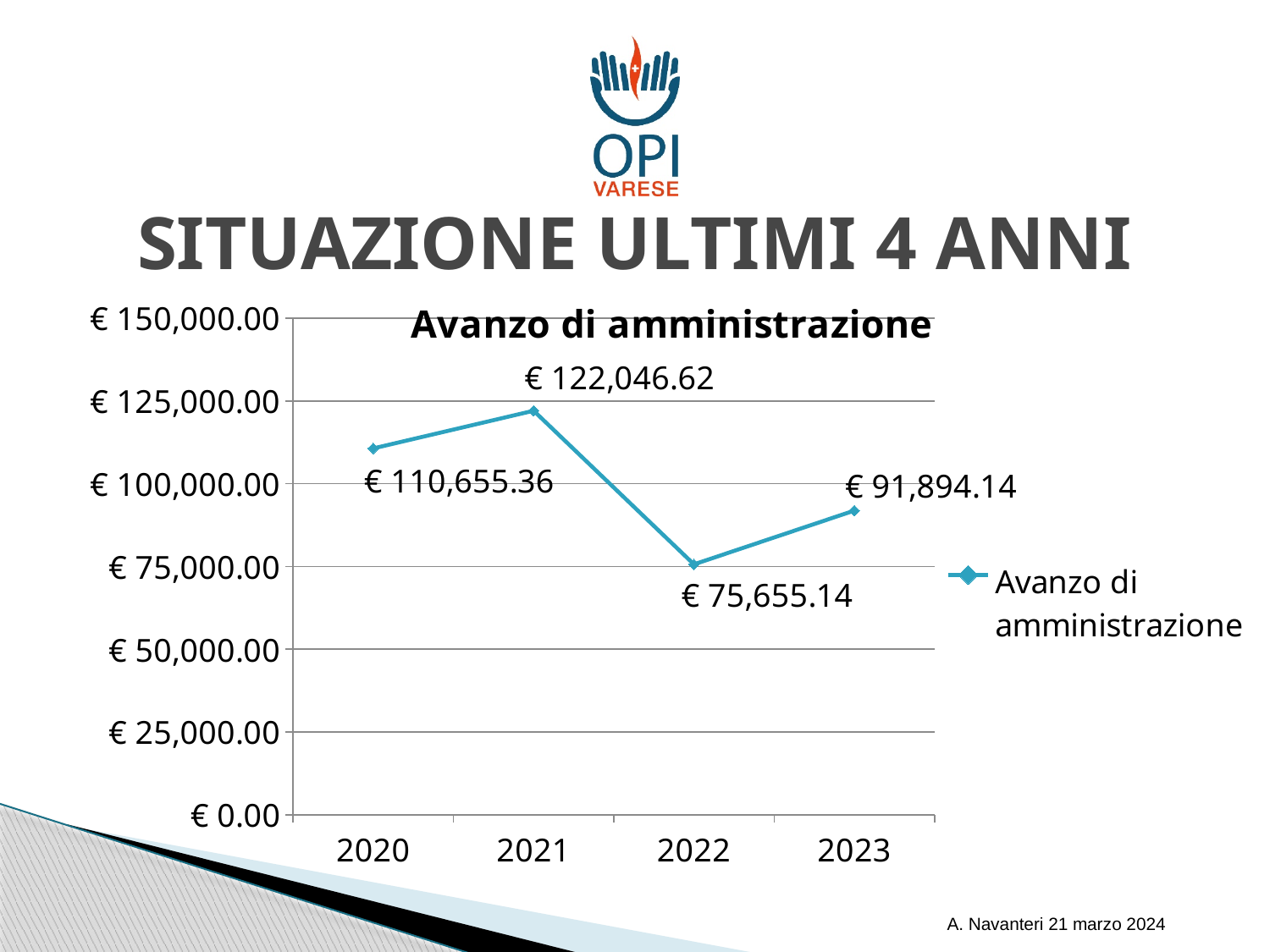
What is the value for 2021 in the Avanzo di amministrazione chart? € 122,046.62 What kind of chart is used to show the Avanzo di amministrazione? Line chart Which is larger, the Avanzo di amministrazione in 2020 or in 2023? 2020 What is the value for 2023 in the Avanzo di amministrazione chart? € 91,894.14 How many years are plotted in the Avanzo di amministrazione chart? 4 By how much did the Avanzo di amministrazione increase from 2022 to 2023? € 16,239.00 Which year has the highest Avanzo di amministrazione? 2021 What is the value for 2022 in the Avanzo di amministrazione chart? € 75,655.14 Which year has the lowest Avanzo di amministrazione? 2022 What is the difference between the 2021 and 2022 values of Avanzo di amministrazione? € 46,391.48 Does the Avanzo di amministrazione rise or fall from 2021 to 2022? Fall What is the value for 2020 in the Avanzo di amministrazione chart? € 110,655.36